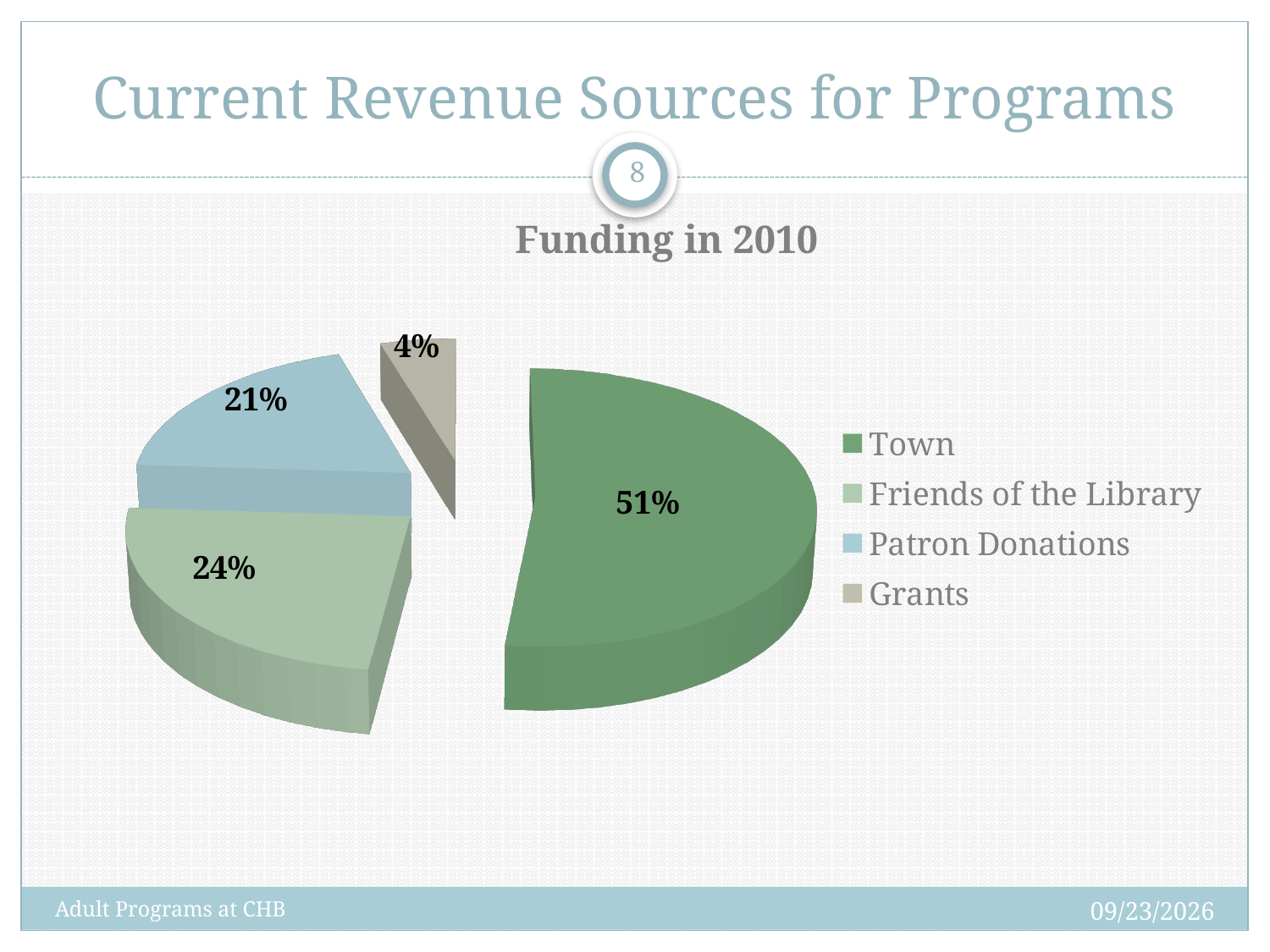
What type of chart is shown on the slide? Pie chart Which funding source has the largest share of the pie? Town Which is larger, the share from Patron Donations or the share from Grants? Patron Donations What is the title of the chart? Funding in 2010 What share of funding in 2010 came from Patron Donations? 21% Which funding source has the smallest share of the pie? Grants What share of funding in 2010 came from Friends of the Library? 24% What is the difference in percentage points between the Friends of the Library share and the Patron Donations share? 3 How many funding sources are shown in the pie chart? 4 What share of funding in 2010 came from the Town? 51% What share of funding in 2010 came from Grants? 4% What is the difference in percentage points between the Town share and the Friends of the Library share? 27